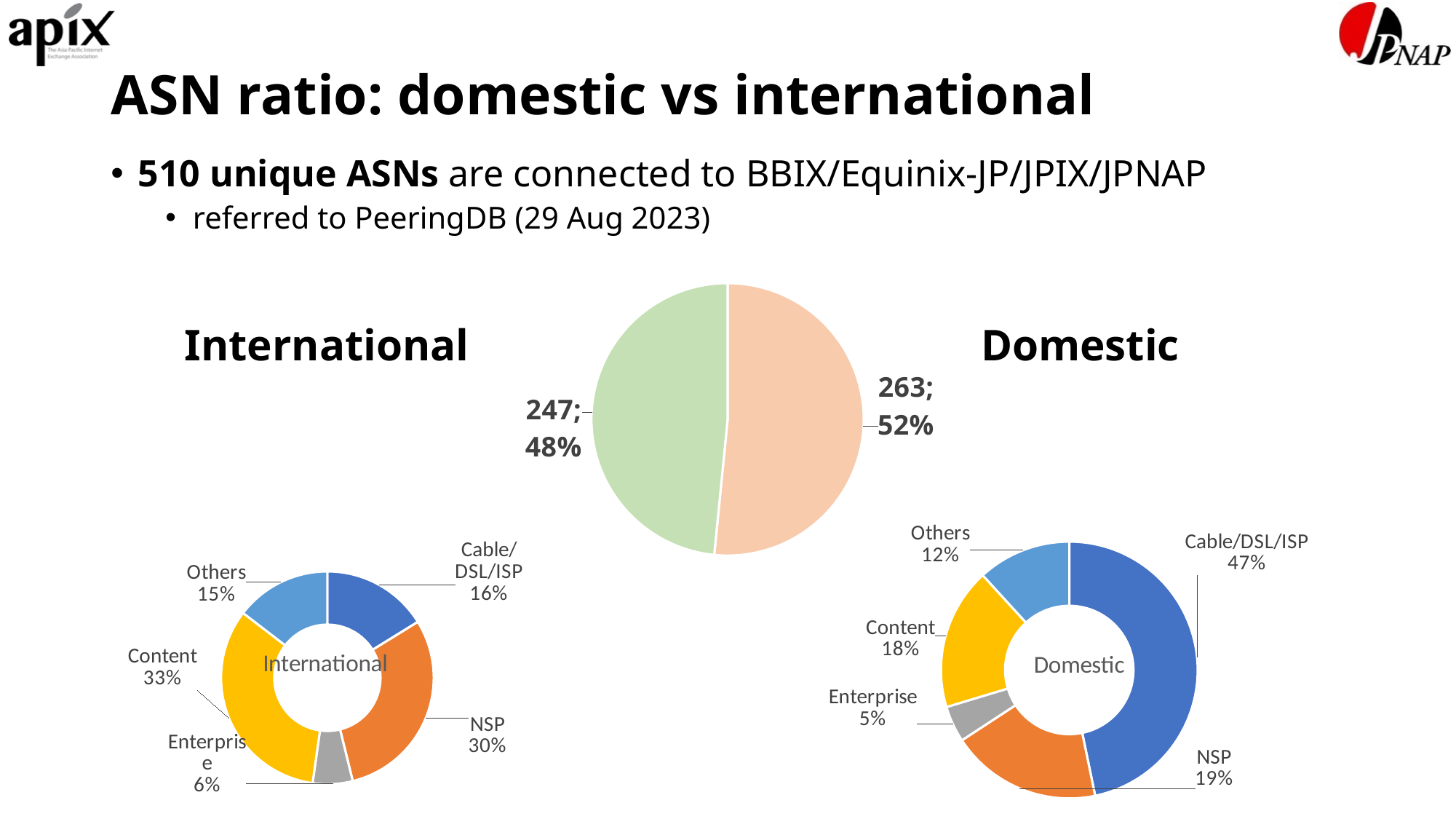
In the central pie chart, which slice is larger, domestic or international? Domestic In the International doughnut chart, what is the share for NSP? 30% In the International doughnut chart, which category has the smallest share? Enterprise In the central pie chart, how many ASNs are domestic? 263 In the International doughnut chart, what share does Content have? 33% In the central pie chart, what percentage of ASNs are international? 48% In the Domestic doughnut chart, what is the difference between the Cable/DSL/ISP share and the NSP share? 28% In the Domestic doughnut chart, what share does Others have? 12% What type of chart is the chart in the centre of the slide? Pie chart In the central pie chart, what is the difference between the domestic and international ASN counts? 16 In the Domestic doughnut chart, which category has the largest share? Cable/DSL/ISP How many categories are shown in the Domestic doughnut chart? 5